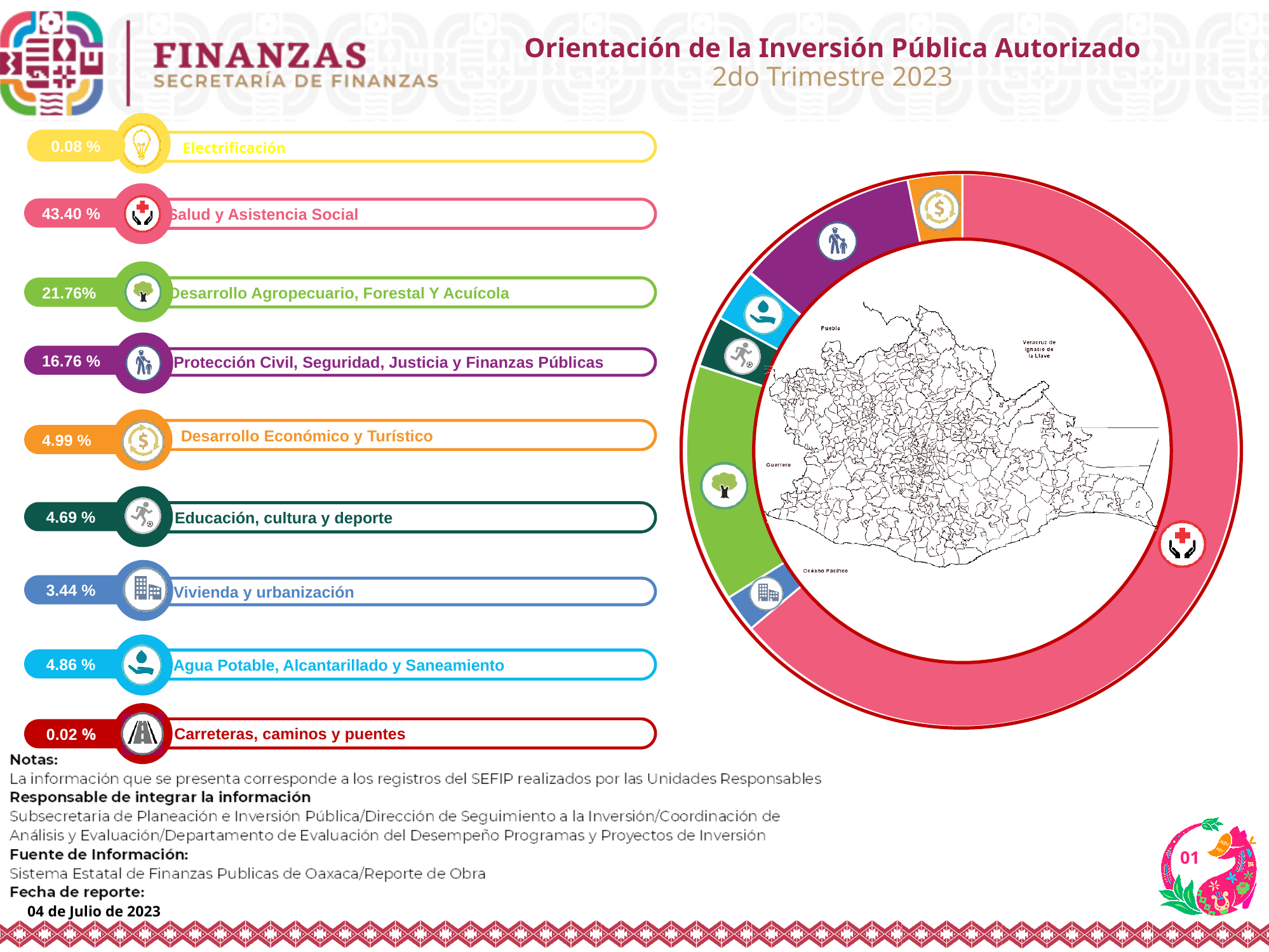
What percentage is shown for Protección Civil, Seguridad, Justicia y Finanzas Públicas? 16.76 % What is the title of the slide containing the chart? Orientación de la Inversión Pública Autorizado Which category has the largest share of the chart? Salud y Asistencia Social What percentage is shown for Carreteras, caminos y puentes? 0.02 % What percentage is shown for Desarrollo Agropecuario, Forestal Y Acuícola? 21.76% What percentage is shown for Vivienda y urbanización? 3.44 % Which has a larger share, Desarrollo Económico y Turístico or Agua Potable, Alcantarillado y Saneamiento? Desarrollo Económico y Turístico What is the difference in percentage points between Salud y Asistencia Social and Desarrollo Agropecuario, Forestal Y Acuícola? 21.64 What percentage is shown for Salud y Asistencia Social? 43.40 % Which category has the smallest share of the chart? Carreteras, caminos y puentes What kind of chart is shown on the slide? Pie (donut) chart How many categories are listed for the chart? 9